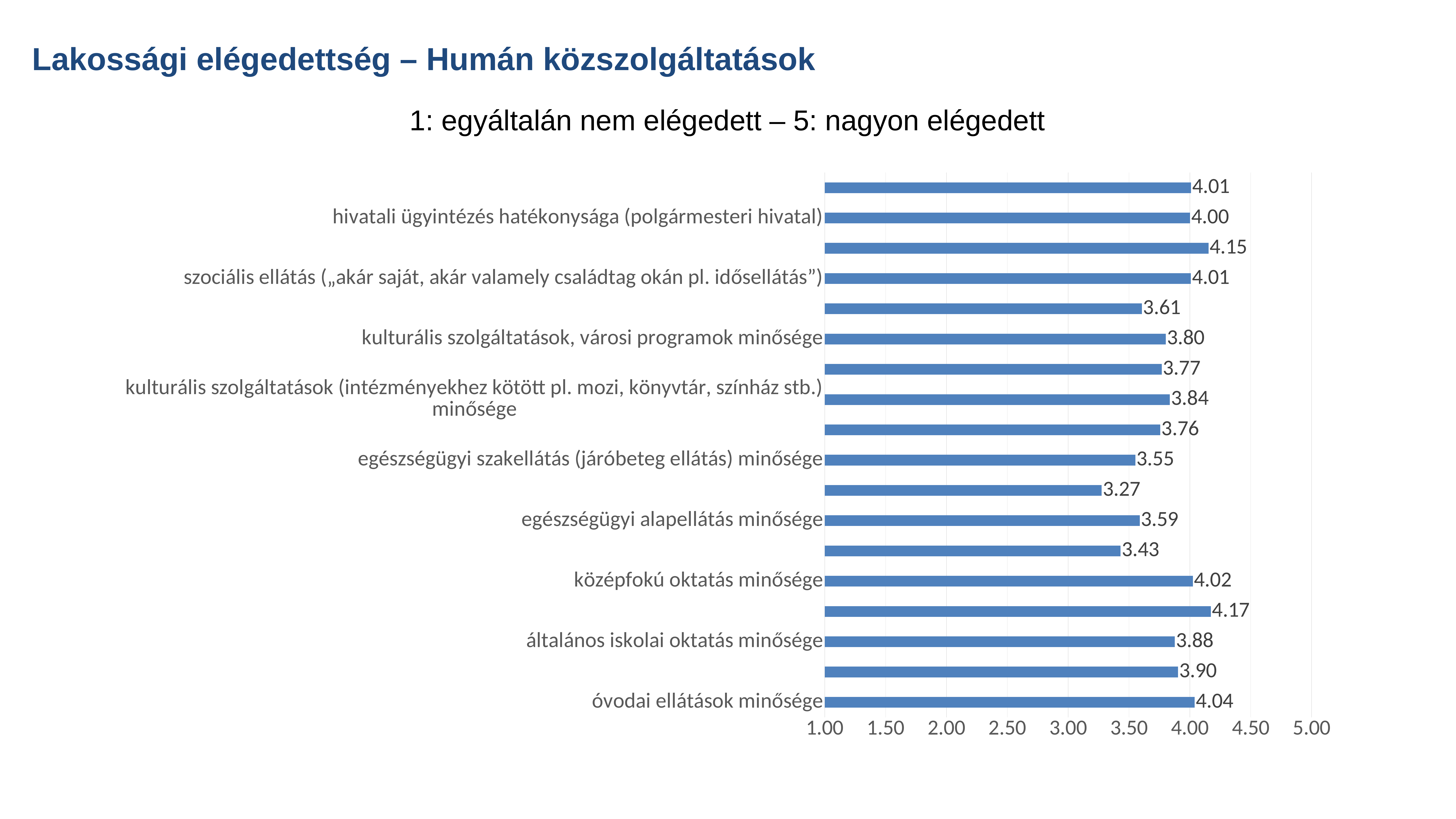
What is the maximum value shown on the horizontal axis? 5.00 Which has a larger value: 'egészségügyi szakellátás (járóbeteg ellátás) minősége' or 'egészségügyi alapellátás minősége'? egészségügyi alapellátás minősége What is the value for 'óvodai ellátások minősége'? 4.04 What is the lowest value shown by any bar in the chart? 3.27 What is the value for 'középfokú oktatás minősége'? 4.02 How many bars are plotted in the chart? 18 What is the difference between the values for 'óvodai ellátások minősége' and 'általános iskolai oktatás minősége'? 0.16 What is the value for 'kulturális szolgáltatások, városi programok minősége'? 3.80 What type of chart is shown on the slide? bar chart What is the value for 'hivatali ügyintézés hatékonysága (polgármesteri hivatal)'? 4.00 What is the highest value shown by any bar in the chart? 4.17 What is the value for 'egészségügyi alapellátás minősége'? 3.59